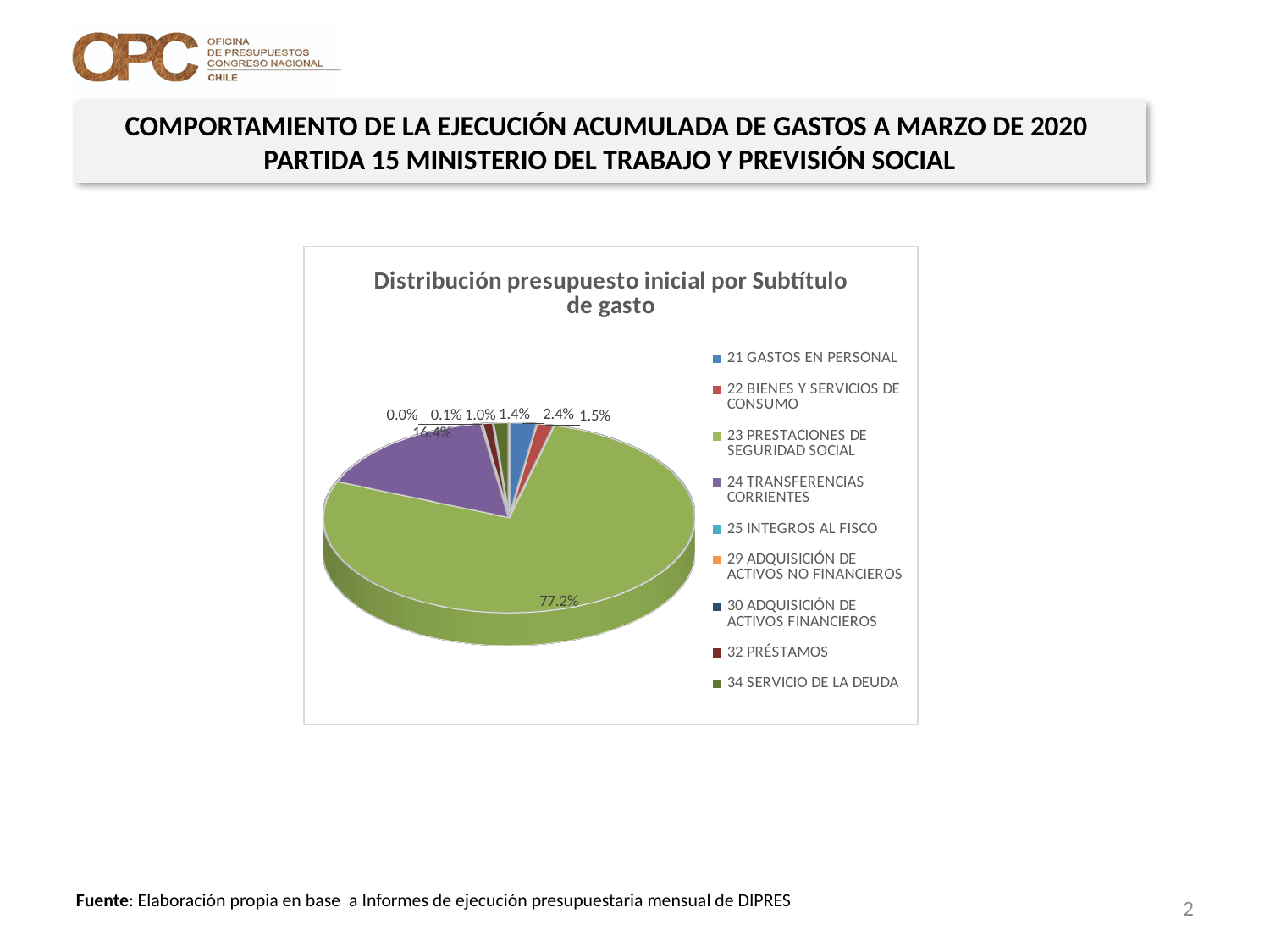
How many entries does the chart legend list? 9 What is the value shown for 21 GASTOS EN PERSONAL? 2.4% Which is larger, the share for 24 TRANSFERENCIAS CORRIENTES or for 21 GASTOS EN PERSONAL? 24 TRANSFERENCIAS CORRIENTES What colour is the slice for 23 PRESTACIONES DE SEGURIDAD SOCIAL? Green What share of the pie does 24 TRANSFERENCIAS CORRIENTES represent? 16.4% What share of the pie does 23 PRESTACIONES DE SEGURIDAD SOCIAL represent? 77.2% Which is larger, the share for 21 GASTOS EN PERSONAL or for 22 BIENES Y SERVICIOS DE CONSUMO? 21 GASTOS EN PERSONAL Which subtítulo has the largest share of the pie? 23 PRESTACIONES DE SEGURIDAD SOCIAL What is the value shown for 22 BIENES Y SERVICIOS DE CONSUMO? 1.5% What is the title of the chart? Distribución presupuesto inicial por Subtítulo de gasto What kind of chart is shown on the slide? Pie chart What is the difference in percentage points between 23 PRESTACIONES DE SEGURIDAD SOCIAL and 24 TRANSFERENCIAS CORRIENTES? 60.8 percentage points